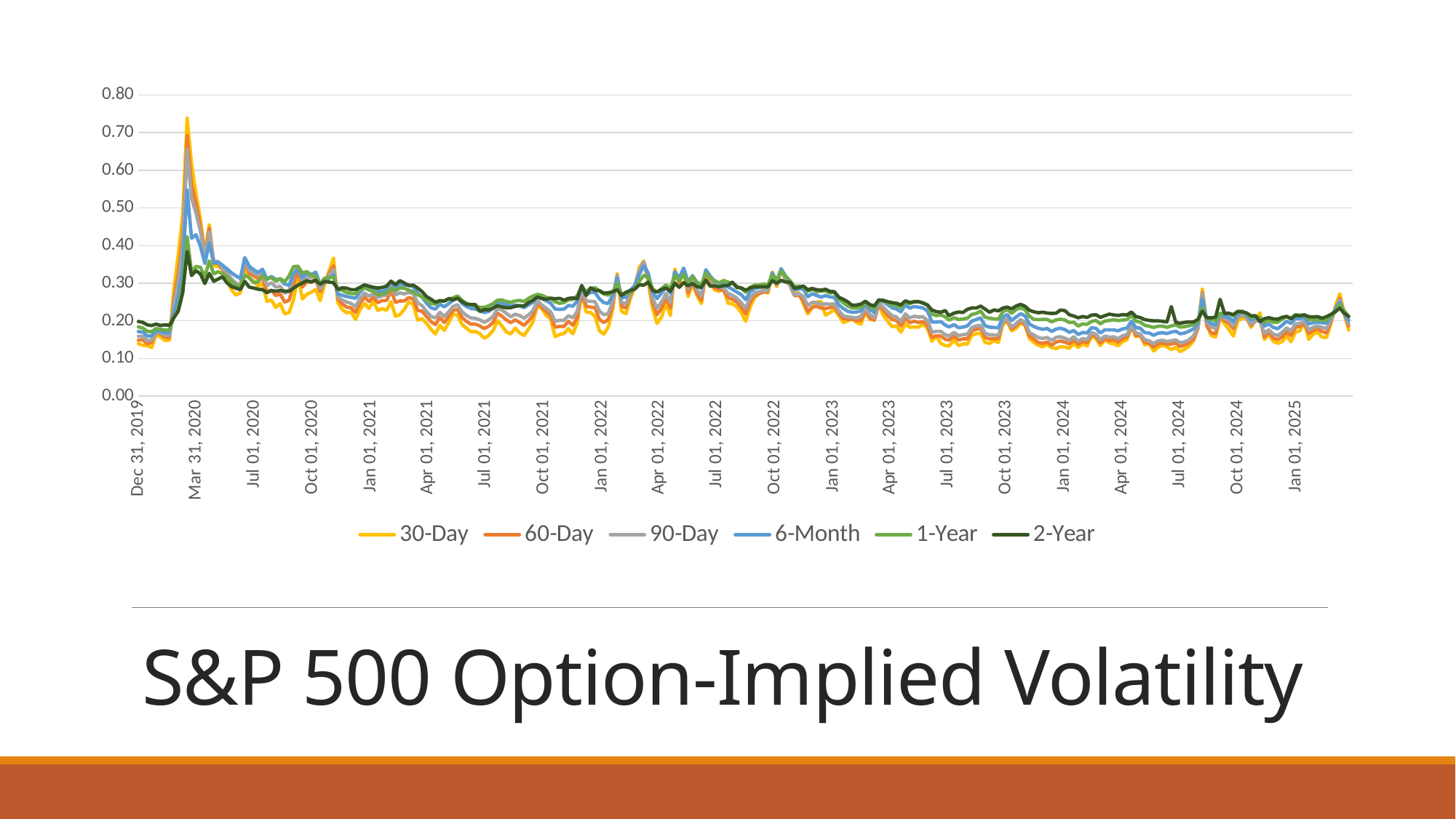
How many series does the legend list? 6 Is the value of the 30-Day series around Jan 01, 2024 greater or less than 0.20? less Is the value of the 2-Year series at Dec 31, 2019 greater or less than 0.30? less Is the peak value of the 30-Day series around Mar 31, 2020 greater or less than 0.60? greater Do the values generally rise or fall from Oct 01, 2022 to Jan 01, 2024? fall How many date labels are shown on the horizontal axis? 21 Which series reaches the highest peak around Mar 31, 2020? 30-Day Around Jan 01, 2024, which series is higher: 2-Year or 30-Day? 2-Year What is the highest value shown on the vertical axis? 0.80 Which series has the lowest peak around Mar 31, 2020? 2-Year What is the title of the chart? S&P 500 Option-Implied Volatility What kind of chart is shown on the slide? Line chart